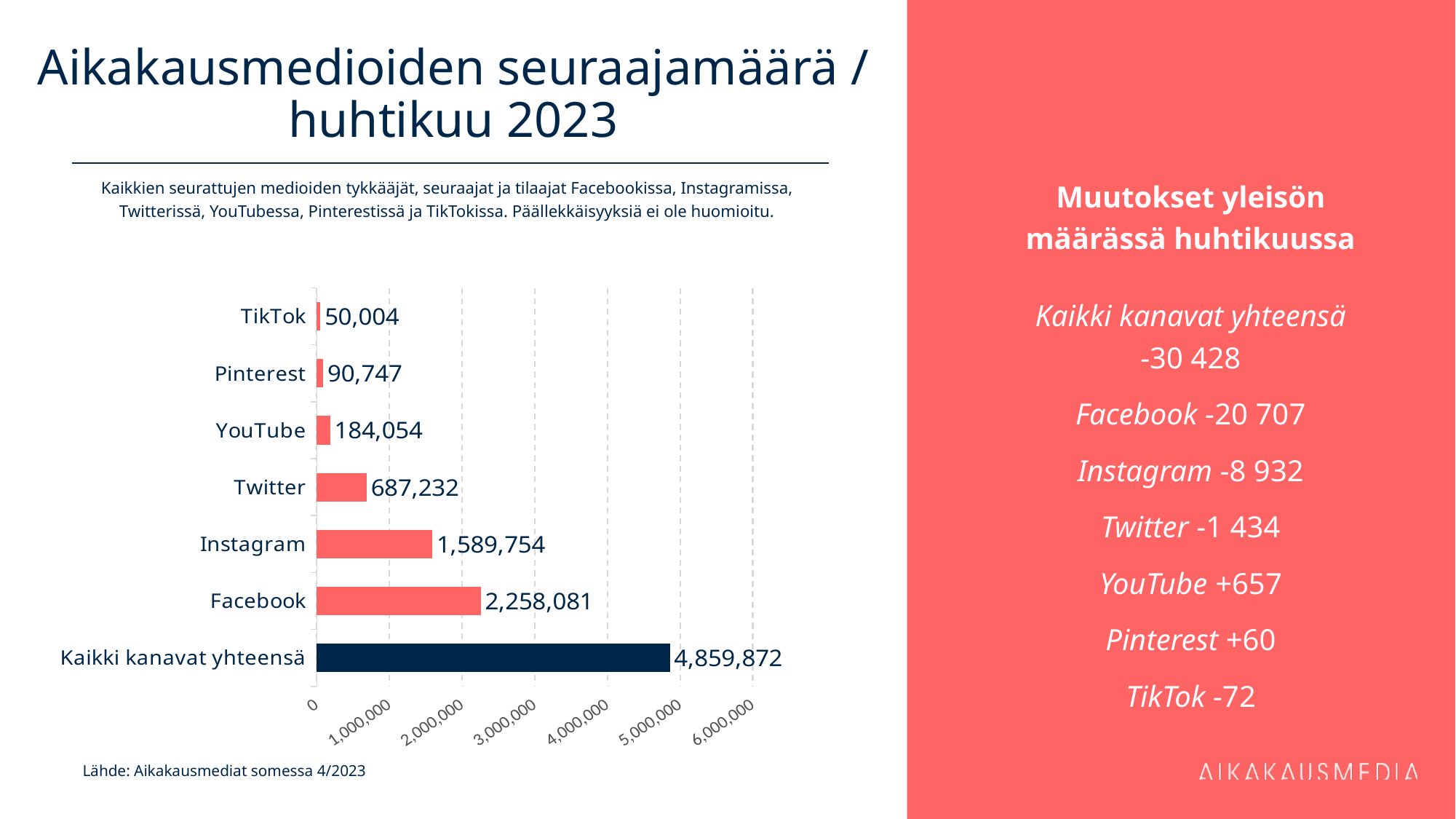
What is the difference between the values for Facebook and Instagram? 668,327 What is the value for Kaikki kanavat yhteensä? 4,859,872 What kind of chart is shown on the slide? Bar chart What is the value for TikTok? 50,004 Which is larger, the value for Pinterest or the value for YouTube? YouTube How many categories are shown in the chart? 7 What is the value for Facebook? 2,258,081 What is the difference between the values for Twitter and YouTube? 503,178 What is the value for Instagram? 1,589,754 Which category has the highest value? Kaikki kanavat yhteensä Which bar is shown in a different colour (dark navy) from the others? Kaikki kanavat yhteensä Which category has the lowest value? TikTok